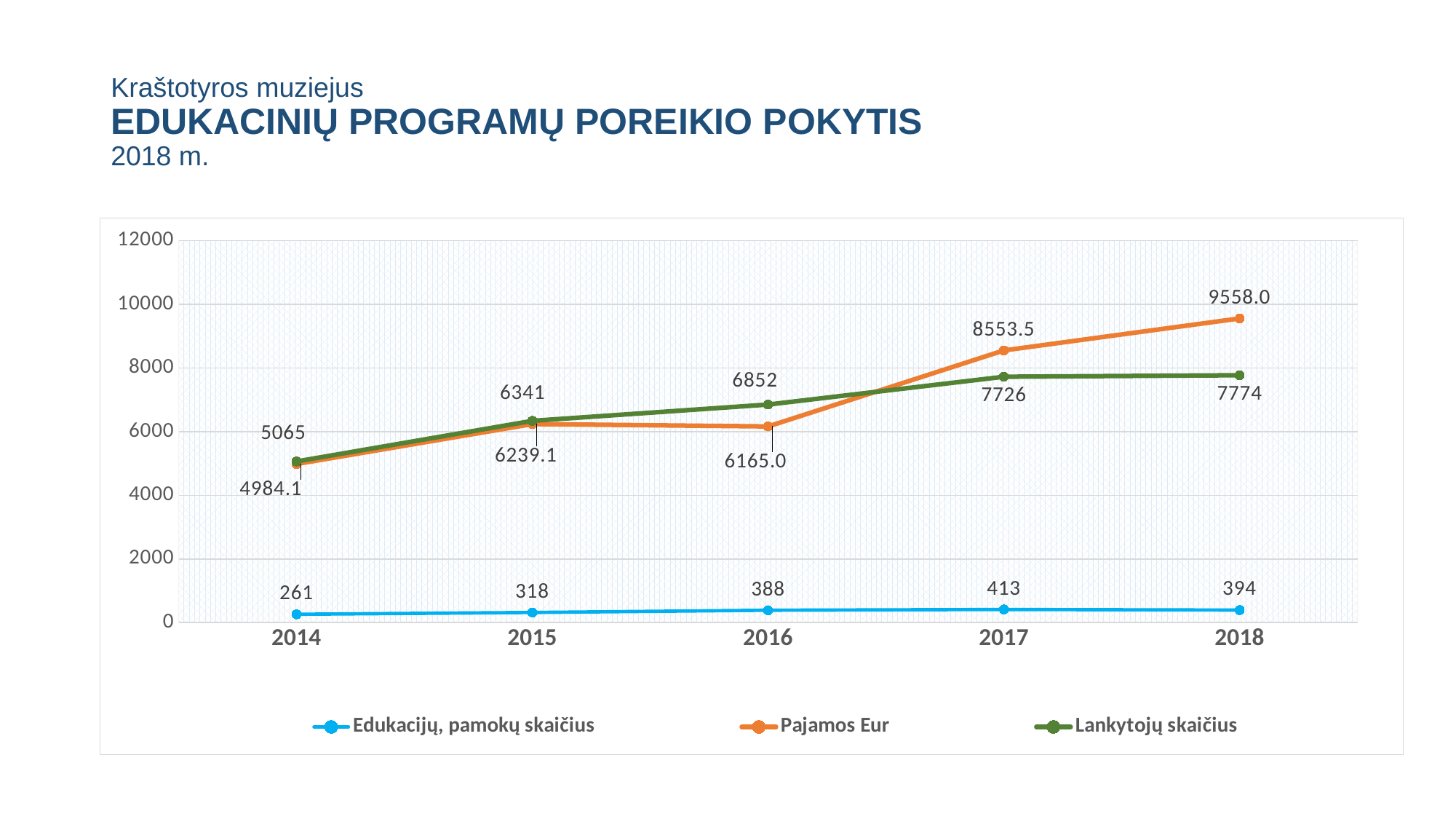
What kind of chart is shown on the slide? line chart Is the value of Pajamos Eur in 2017 greater or less than 8000? greater Does Lankytojų skaičius rise or fall from 2014 to 2018? rise How many series does the legend list? 3 How many years are shown on the x axis? 5 In which year is Edukacijų, pamokų skaičius highest? 2017 What is the value of Pajamos Eur in 2018? 9558.0 Which is larger in 2016: Pajamos Eur or Lankytojų skaičius? Lankytojų skaičius In which year is Pajamos Eur lowest? 2014 What is the value of Lankytojų skaičius in 2016? 6852 What is the value of Edukacijų, pamokų skaičius in 2017? 413 What is the difference between Lankytojų skaičius in 2018 and in 2017? 48